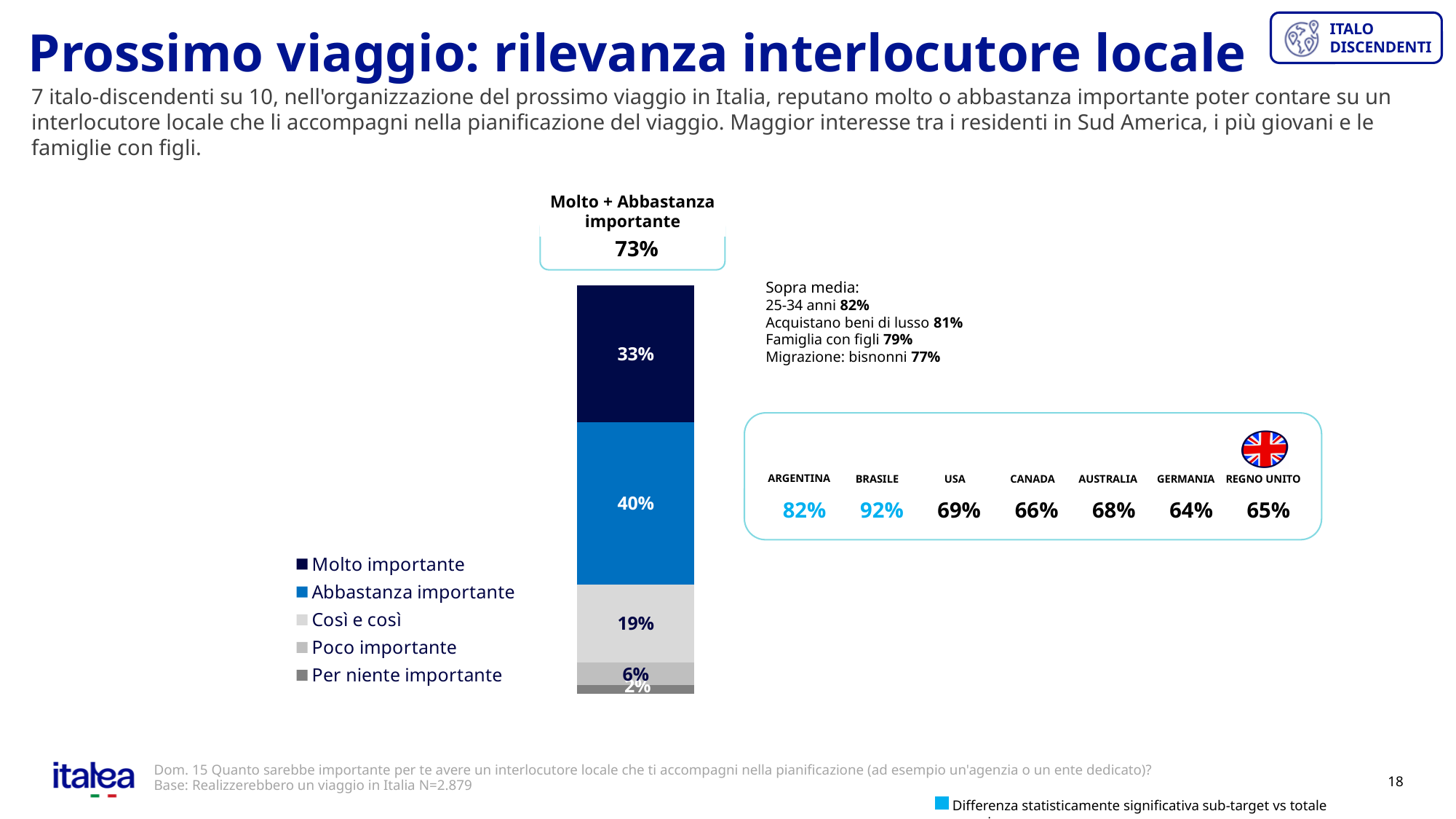
Which response category has the smallest share in the stacked bar? Per niente importante What combined value is shown in the box above the bar for "Molto + Abbastanza importante"? 73% What percentage of respondents rated a local contact as "Molto importante"? 33% What percentage of respondents answered "Abbastanza importante"? 40% How many series does the legend list? 5 What is the value shown for "Così e così"? 19% Which is larger, the share for "Così e così" or the share for "Poco importante"? Così e così What is the difference between the "Abbastanza importante" and "Molto importante" shares? 7% What is the value shown for "Per niente importante"? 2% Which response category has the largest share in the stacked bar? Abbastanza importante What is the value shown for "Poco importante"? 6% What kind of chart is shown on the slide? Stacked bar chart